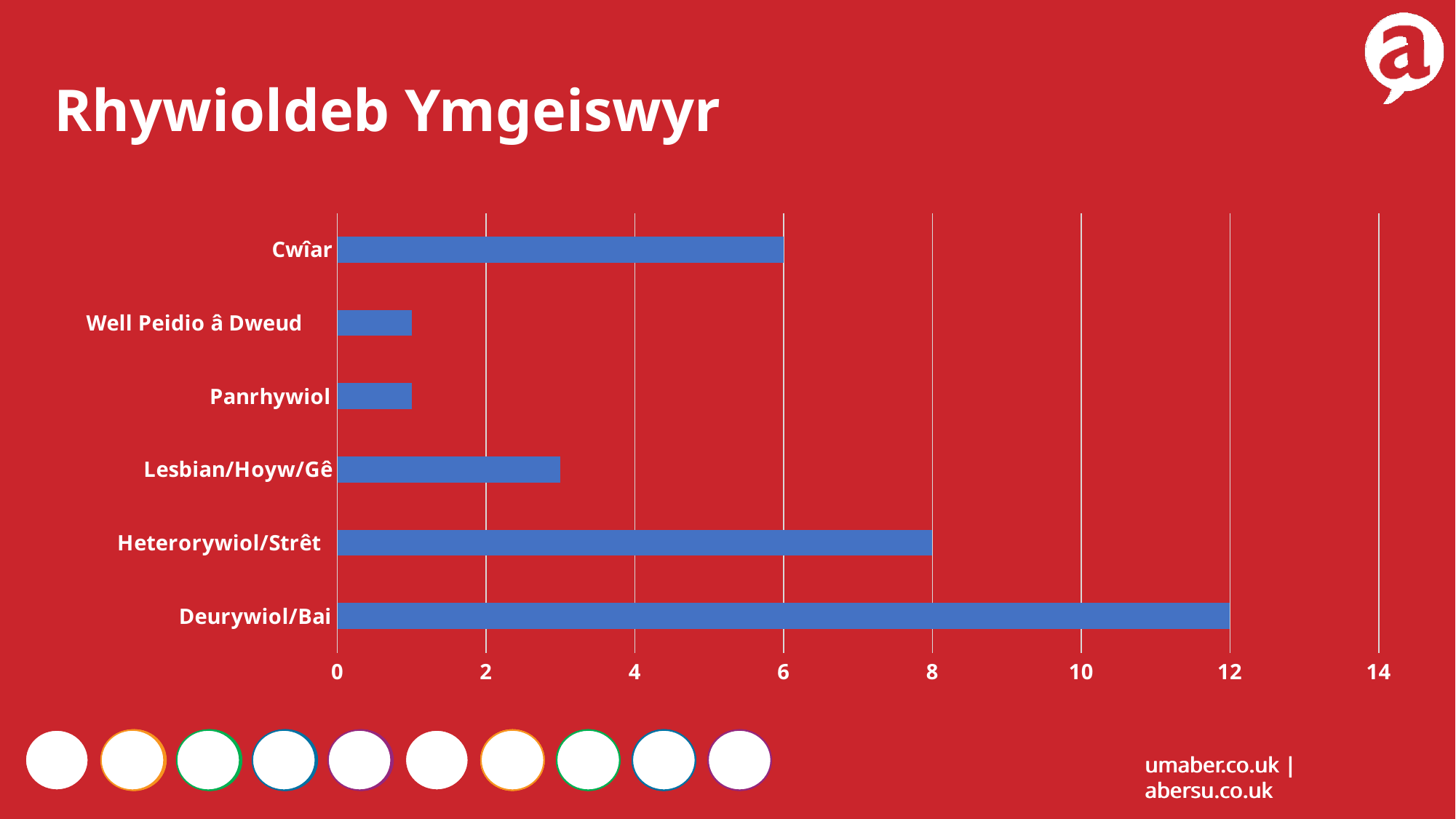
What is the value for Deurywiol/Bai? 12 What is the title of the slide? Rhywioldeb Ymgeiswyr How many categories are shown in the chart? 6 What is the difference between the values for Deurywiol/Bai and Heterorywiol/Strêt? 4 Is the value for Lesbian/Hoyw/Gê greater or less than 4? less What kind of chart is shown on the slide? bar chart Which is larger, the value for Cwîar or the value for Lesbian/Hoyw/Gê? Cwîar Is the value for Well Peidio â Dweud greater or less than 2? less What is the value for Cwîar? 6 What is the value for Heterorywiol/Strêt? 8 What is the difference between the values for Heterorywiol/Strêt and Cwîar? 2 Which category has the highest value? Deurywiol/Bai